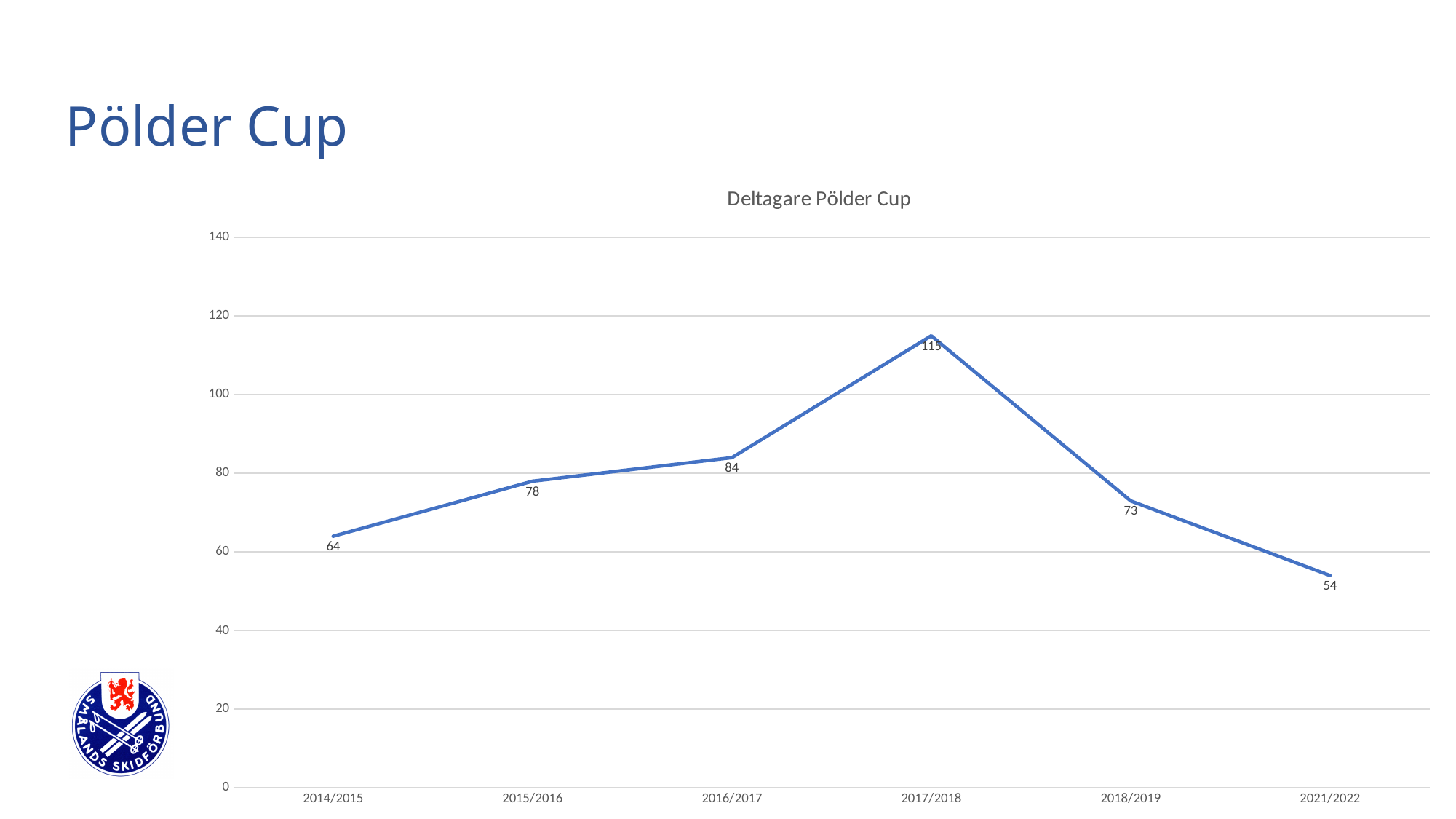
How many seasons are plotted on the x axis? 6 Which season has the lowest value? 2021/2022 What is the value for 2017/2018? 115 Which season has the highest value? 2017/2018 What is the value for 2014/2015? 64 What kind of chart is shown? line chart What is the value for 2018/2019? 73 What is the difference between the values for 2017/2018 and 2016/2017? 31 Which is larger, the value for 2015/2016 or the value for 2018/2019? 2015/2016 Is the value for 2017/2018 greater or less than 100? greater What is the value for 2021/2022? 54 What is the title of the chart? Deltagare Pölder Cup